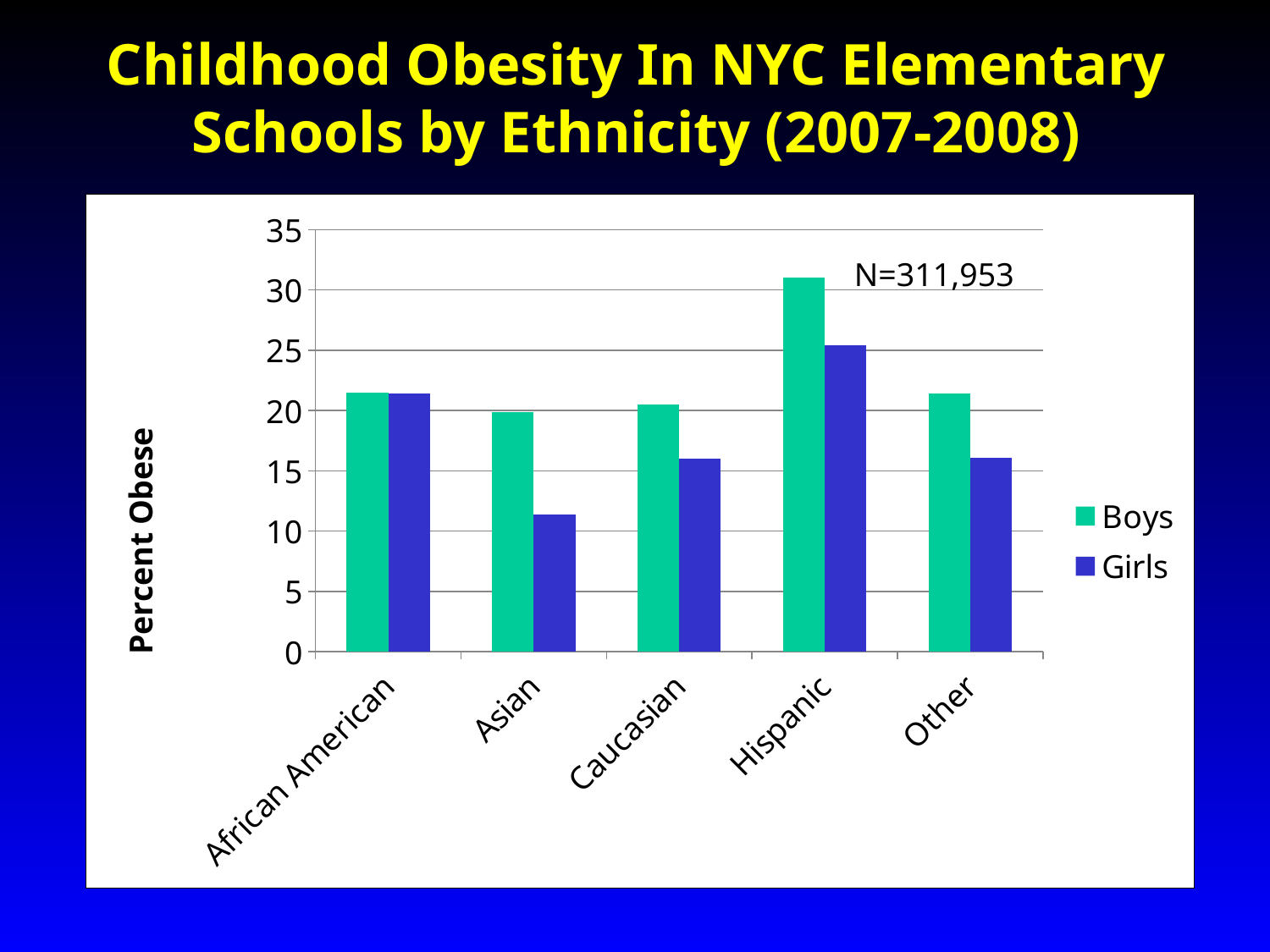
What sample size (N) is printed on the chart? N=311,953 Which ethnic category has the highest percent obese for Girls? Hispanic How many series does the legend list? 2 Is the percent obese for Asian Girls greater or less than 15? less How many ethnic categories are shown on the x axis? 5 For the Asian category, which is larger: the Boys value or the Girls value? Boys Which ethnic category has the lowest percent obese for Girls? Asian What kind of chart is shown on the slide? Bar chart Which ethnic category has the highest percent obese for Boys? Hispanic Is the percent obese for Hispanic Boys greater or less than 30? greater Which is larger: the Boys value for Hispanic or the Boys value for Other? Hispanic Is the percent obese for Caucasian Girls greater or less than 20? less